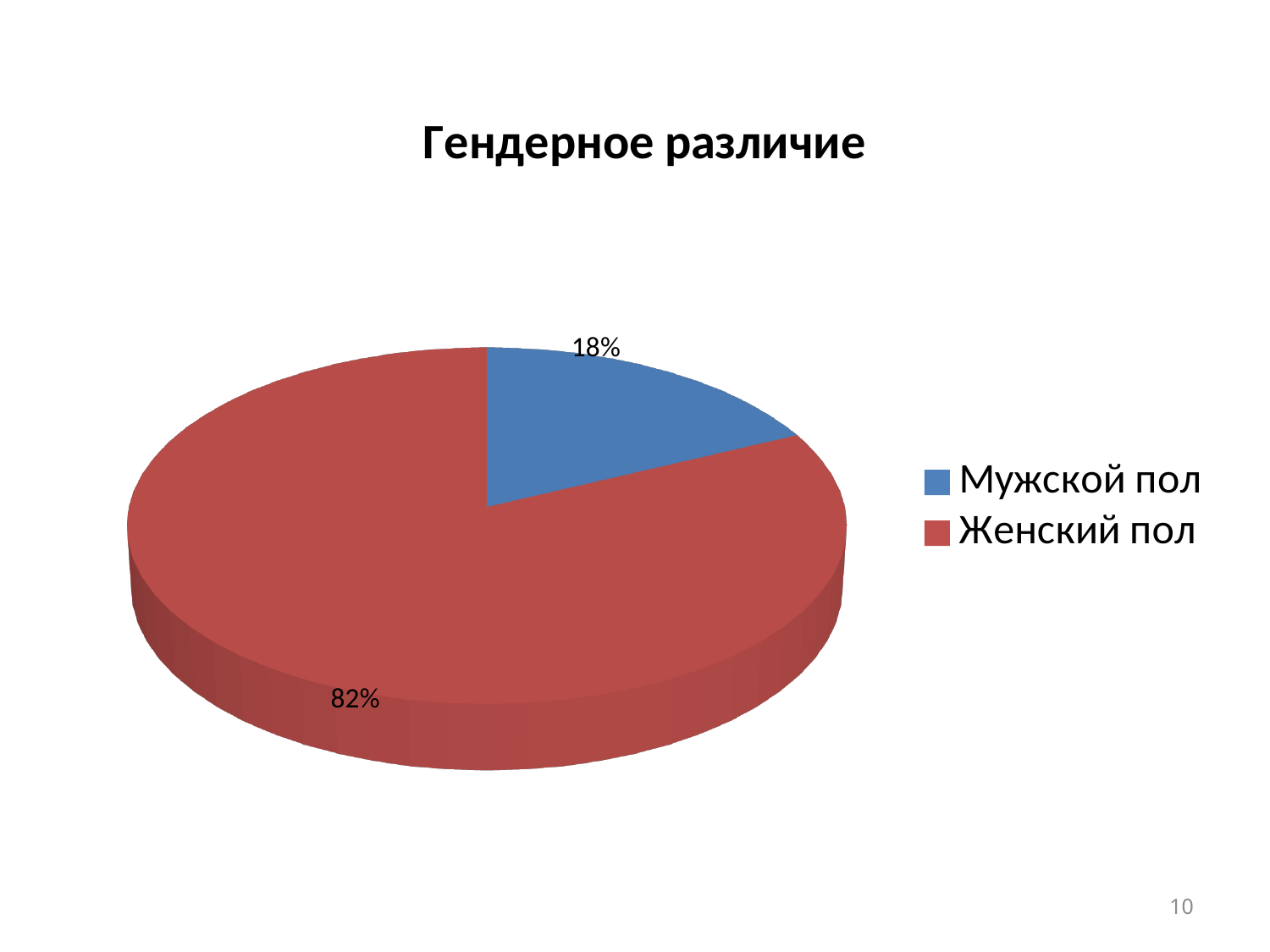
How many categories does the pie chart have? 2 What share of the pie is Женский пол? 82% What is the difference in percentage points between Женский пол and Мужской пол? 64 How many entries does the legend list? 2 Which is larger, the slice for Мужской пол or the slice for Женский пол? Женский пол What kind of chart is shown on the slide? pie chart What share of the pie is Мужской пол? 18% What is the title of the chart? Гендерное различие Which category has the smallest slice of the pie? Мужской пол What colour is the slice for Мужской пол? blue Which category has the largest slice of the pie? Женский пол